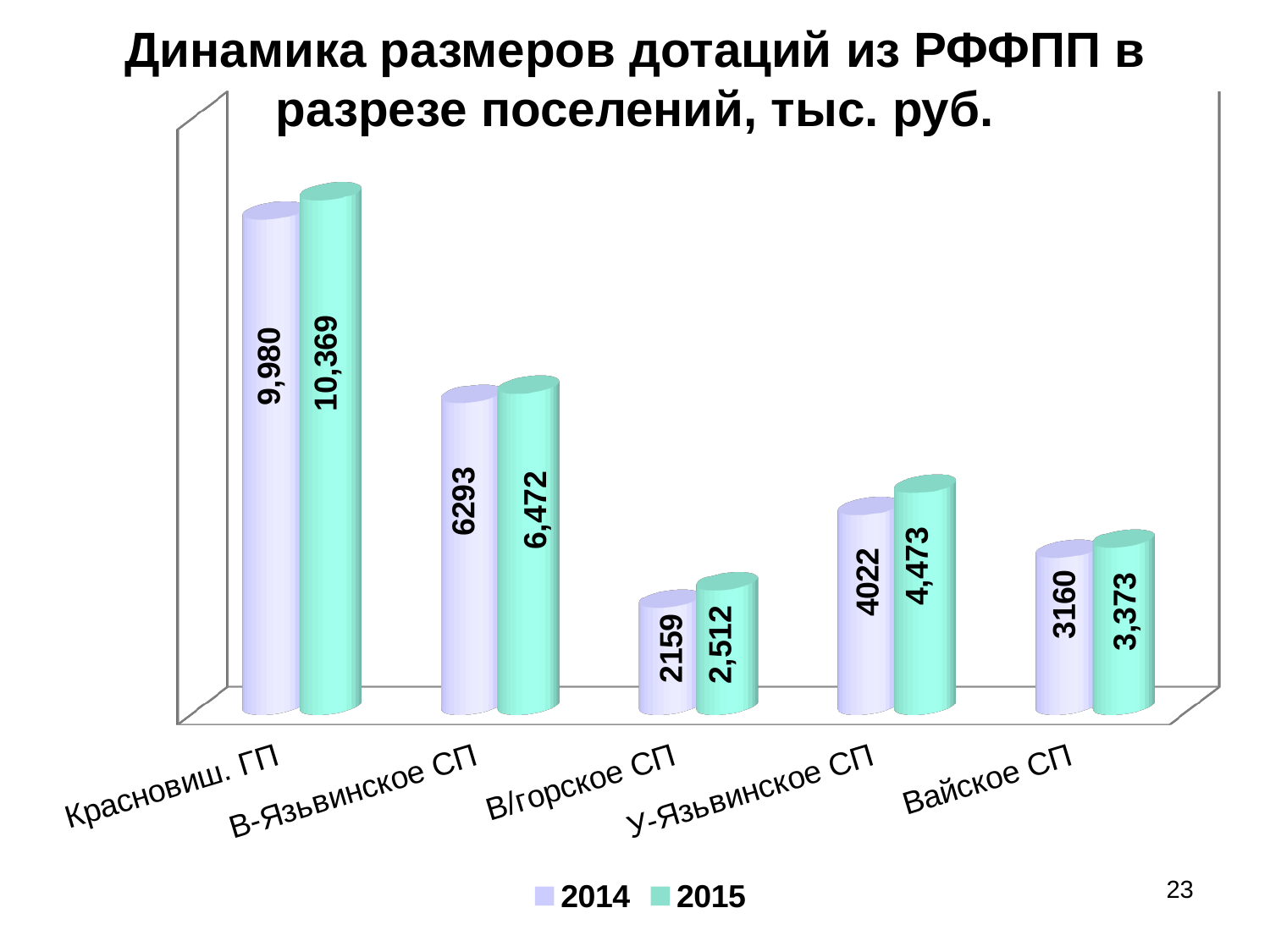
Which settlement has the highest 2015 value? Красновиш. ГП What is the 2014 value for В/горское СП? 2159 What is the 2015 value for У-Язьвинское СП? 4,473 What is the difference between the 2015 and 2014 values for Красновиш. ГП? 389 What is the 2014 value for Красновиш. ГП? 9,980 How many series does the legend list? 2 How many settlements are shown on the x axis? 5 What kind of chart is shown on the slide? Bar chart What is the 2015 value for Вайское СП? 3,373 What is the difference between the 2015 and 2014 values for У-Язьвинское СП? 451 Which settlement has the lowest 2014 value? В/горское СП Which is larger for В-Язьвинское СП: the 2014 value or the 2015 value? 2015